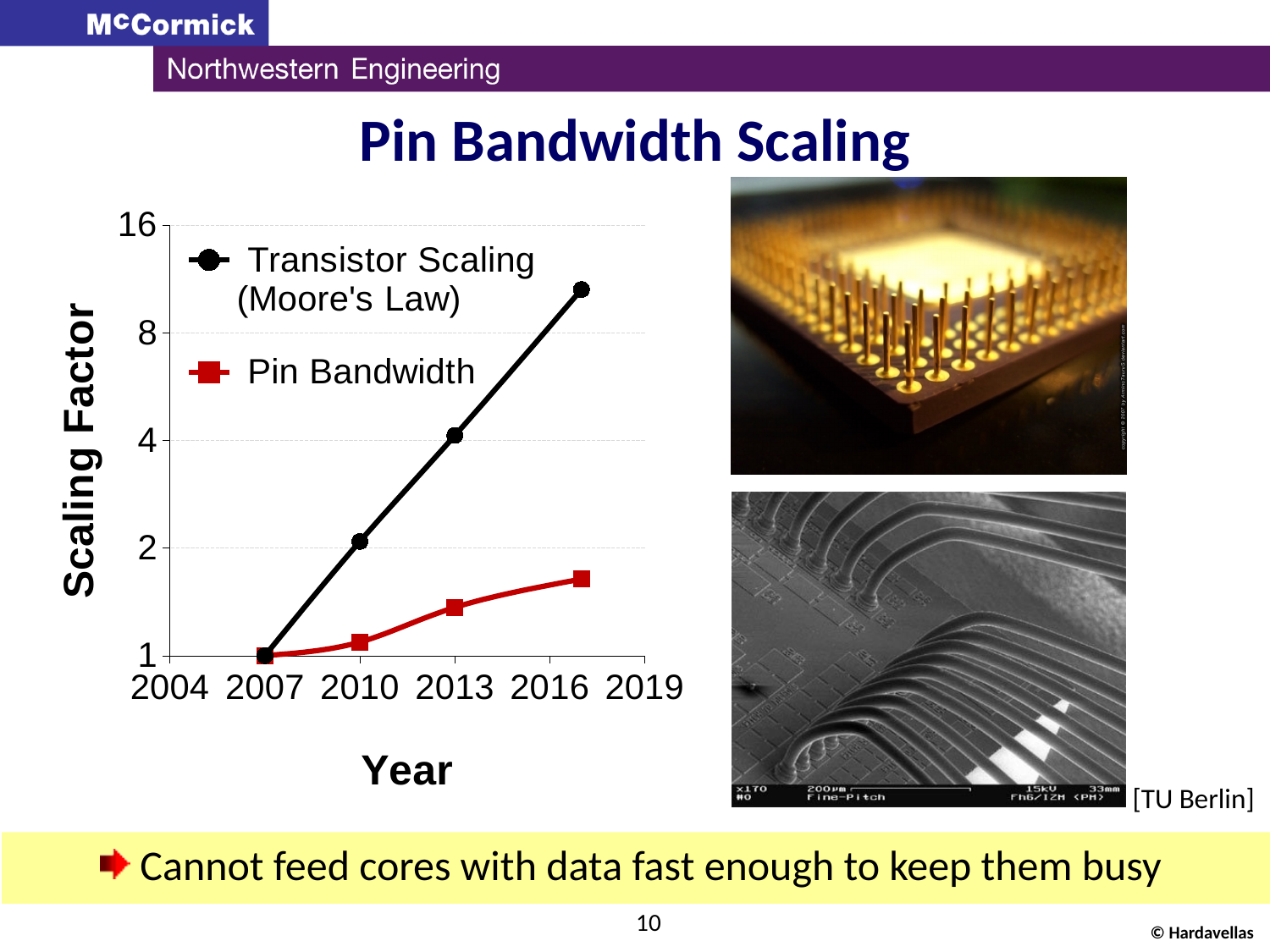
What is the title of the chart on the slide? Pin Bandwidth Scaling Does the Transistor Scaling (Moore's Law) series rise or fall as the year increases? rise Does the Pin Bandwidth series rise or fall as the year increases? rise What kind of chart is shown on the slide? line chart What is the label of the y axis of the chart? Scaling Factor Is the value of Transistor Scaling (Moore's Law) in 2013 greater or less than 2? greater Which series has the higher value at the last plotted year, Transistor Scaling (Moore's Law) or Pin Bandwidth? Transistor Scaling (Moore's Law) Is the value of Pin Bandwidth at its last plotted point greater or less than 2? less Which series is drawn in red on the chart? Pin Bandwidth How many data points are plotted for the Pin Bandwidth series? 4 Is the value of Transistor Scaling (Moore's Law) at its last plotted point greater or less than 8? greater How many series does the chart's legend list? 2